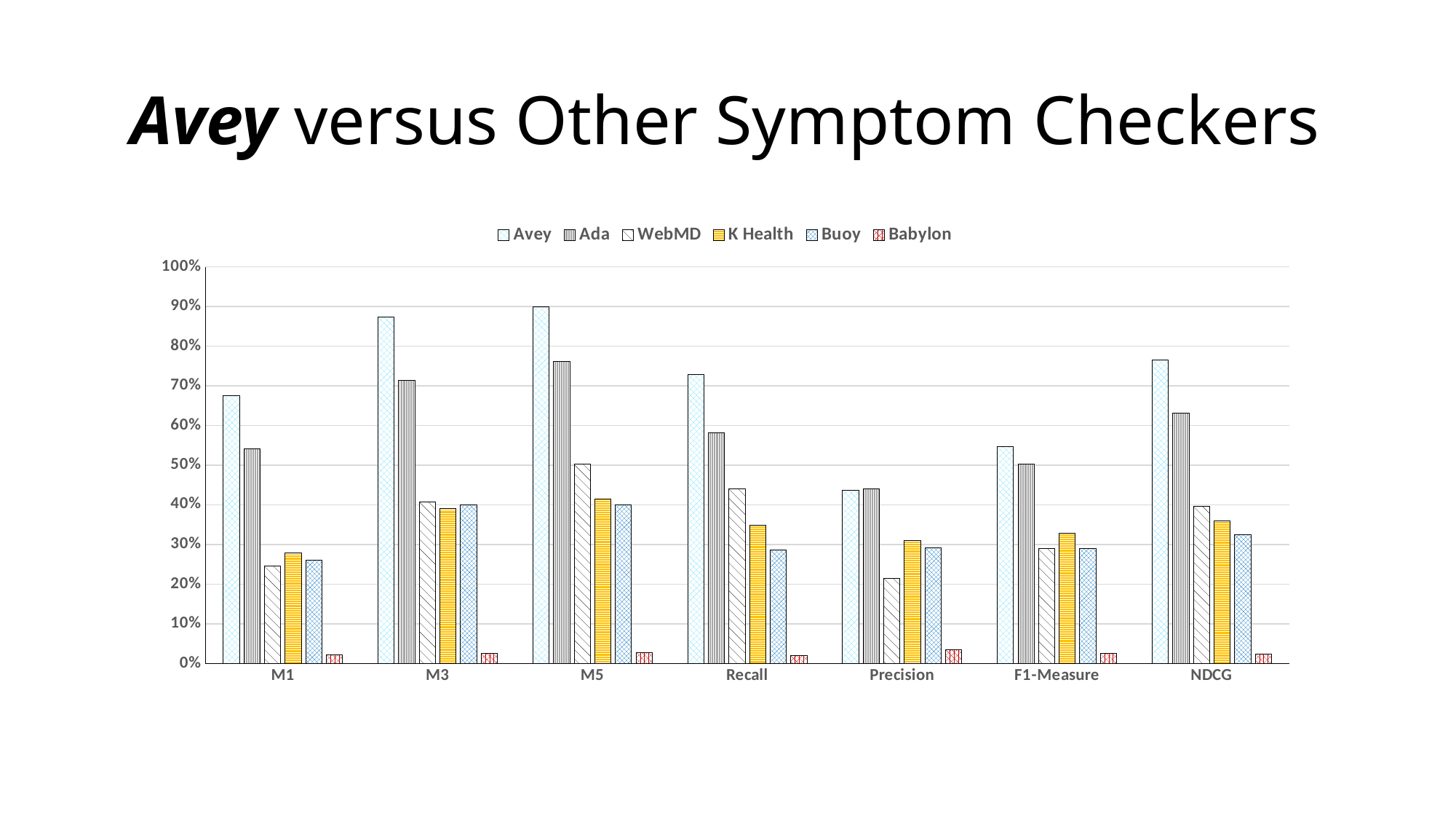
In which category does Ada reach its highest value? M5 In the Recall category, which is larger: Ada or WebMD? Ada What kind of chart is shown on the slide? bar chart How many categories are shown along the x axis? 7 Is the value for Babylon in the Precision category greater or less than 10%? less Is the value for Avey in the M5 category greater or less than 80%? greater How many series does the legend list? 6 Is the value for Ada in the M1 category greater or less than 60%? less Which series has the lowest value in the Recall category? Babylon In the F1-Measure category, which is larger: K Health or Buoy? K Health Which series has the highest value in the M3 category? Avey